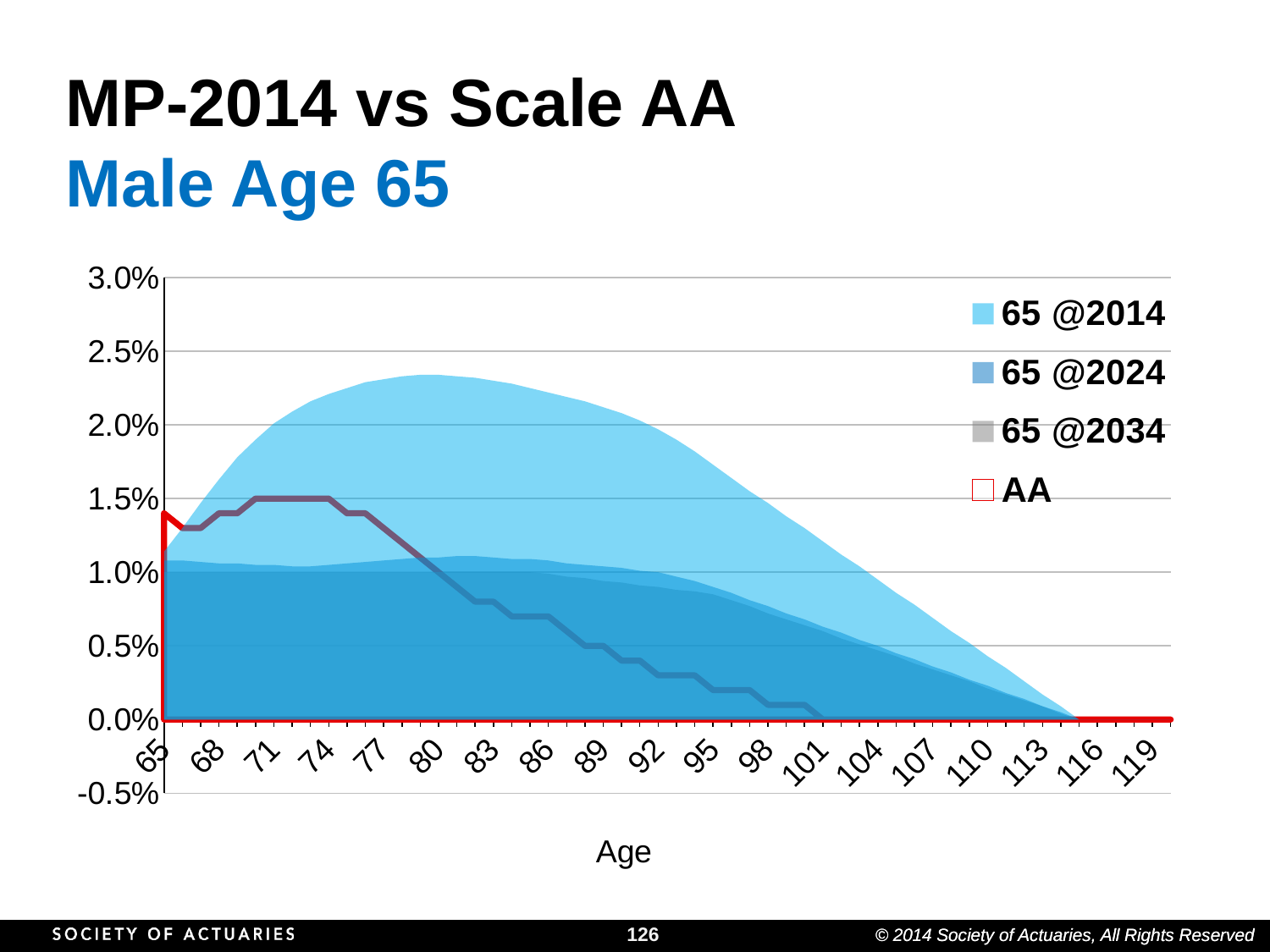
Is the value for 65 @2014 at age 110 greater or less than 1.0%? less Is the value for AA at age 86 greater or less than 1.0%? less What is the title of the x axis? Age Which series reaches the highest value on the chart? 65 @2014 At age 80, which is larger: 65 @2014 or AA? 65 @2014 Is the value for 65 @2024 at age 71 greater or less than 1.5%? less Does the AA line rise or fall between age 77 and age 101? Fall What is the highest value shown on the y axis? 3.0% What kind of chart is this? Area chart with a line series How many series does the legend list? 4 What are the four legend entries? 65 @2014, 65 @2024, 65 @2034, AA